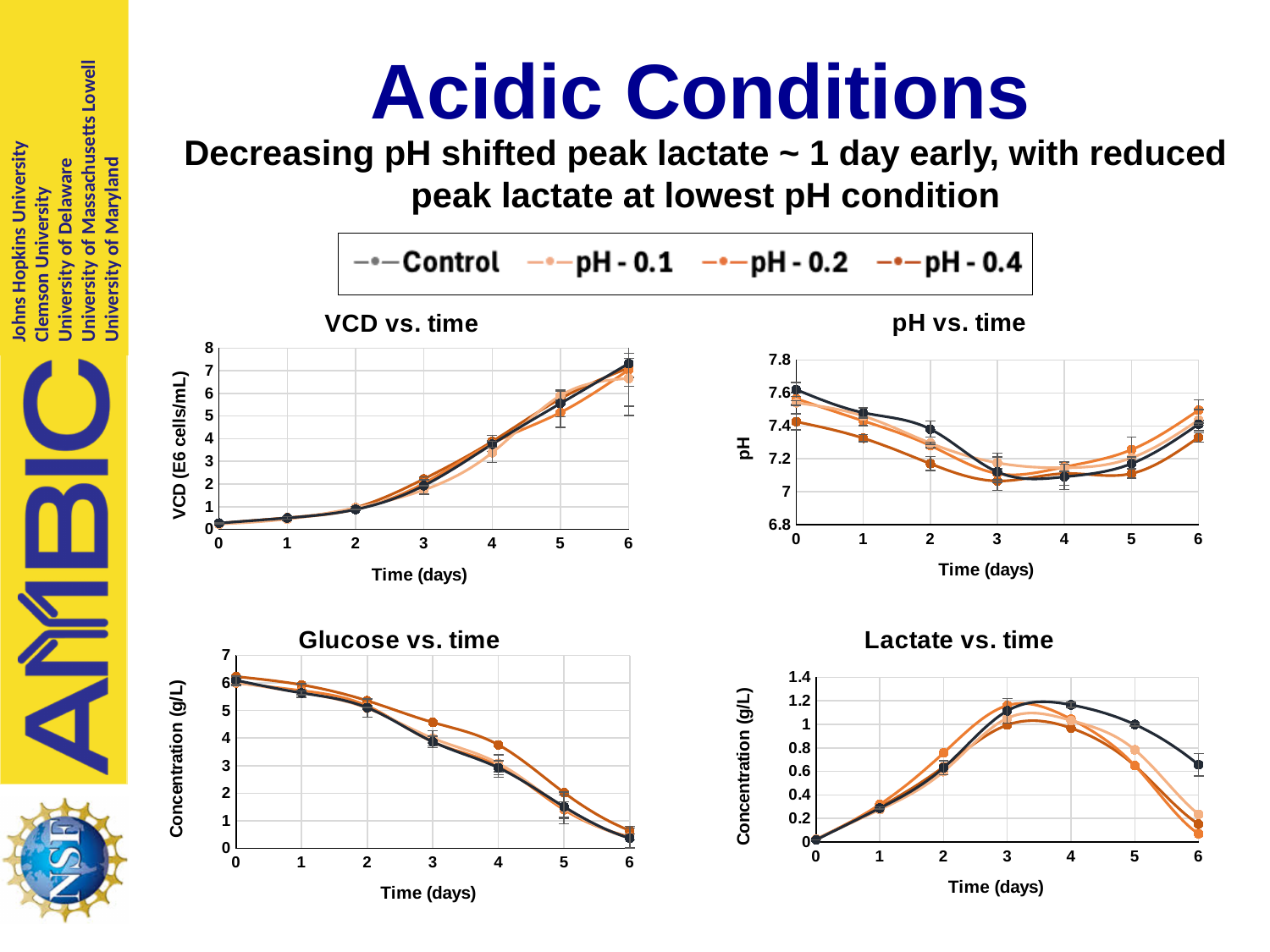
In the "pH vs. time" chart, is the Control value at day 0 greater or less than 7.4? greater In the "Glucose vs. time" chart, is the Control value at day 6 greater or less than 2? less In the "Glucose vs. time" chart, do the values rise or fall as time increases? fall What kind of chart is the "VCD vs. time" chart? line chart In the "Glucose vs. time" chart, how many time points are plotted along the x axis? 7 In the "Lactate vs. time" chart, which is larger at day 6: the Control value or the pH - 0.4 value? Control How many series does the legend list for the charts on this slide? 4 In the "VCD vs. time" chart, do the values rise or fall as time increases? rise In the "Lactate vs. time" chart, is the Control value at day 4 greater or less than 1? greater What is the y-axis label of the "Lactate vs. time" chart? Concentration (g/L)